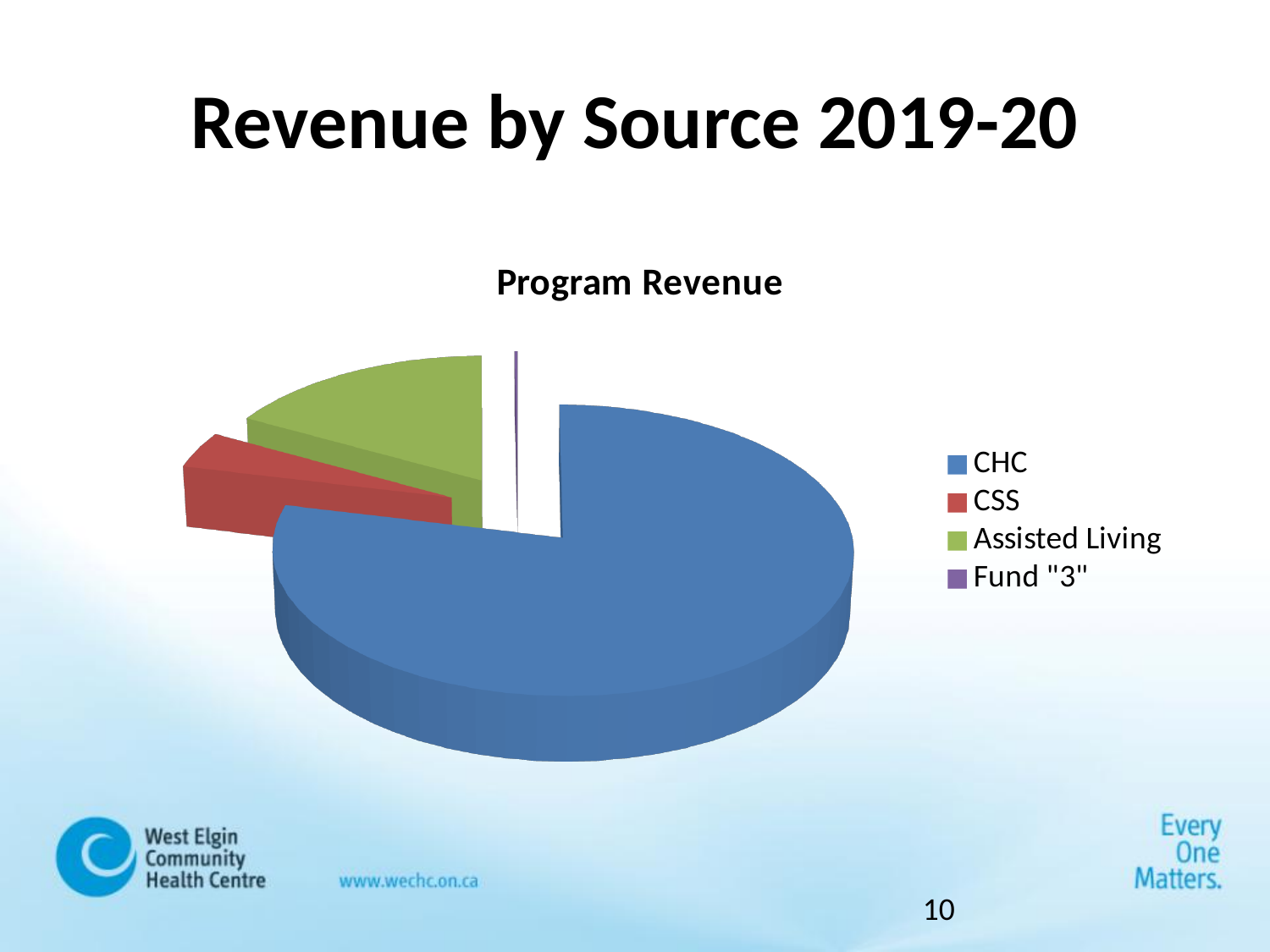
Which category has the largest slice of the pie chart? CHC Which slice is larger, Assisted Living or CSS? Assisted Living Does the CHC slice make up more or less than half of the pie? More Which slice is larger, CHC or Assisted Living? CHC Which category has the smallest slice of the pie chart? Fund "3" Which slice is larger, CSS or Fund "3"? CSS What kind of chart is shown on the slide? Pie chart How many categories does the legend of the pie chart list? 4 What colour is the CHC slice in the pie chart? Blue What is the title of the chart? Program Revenue